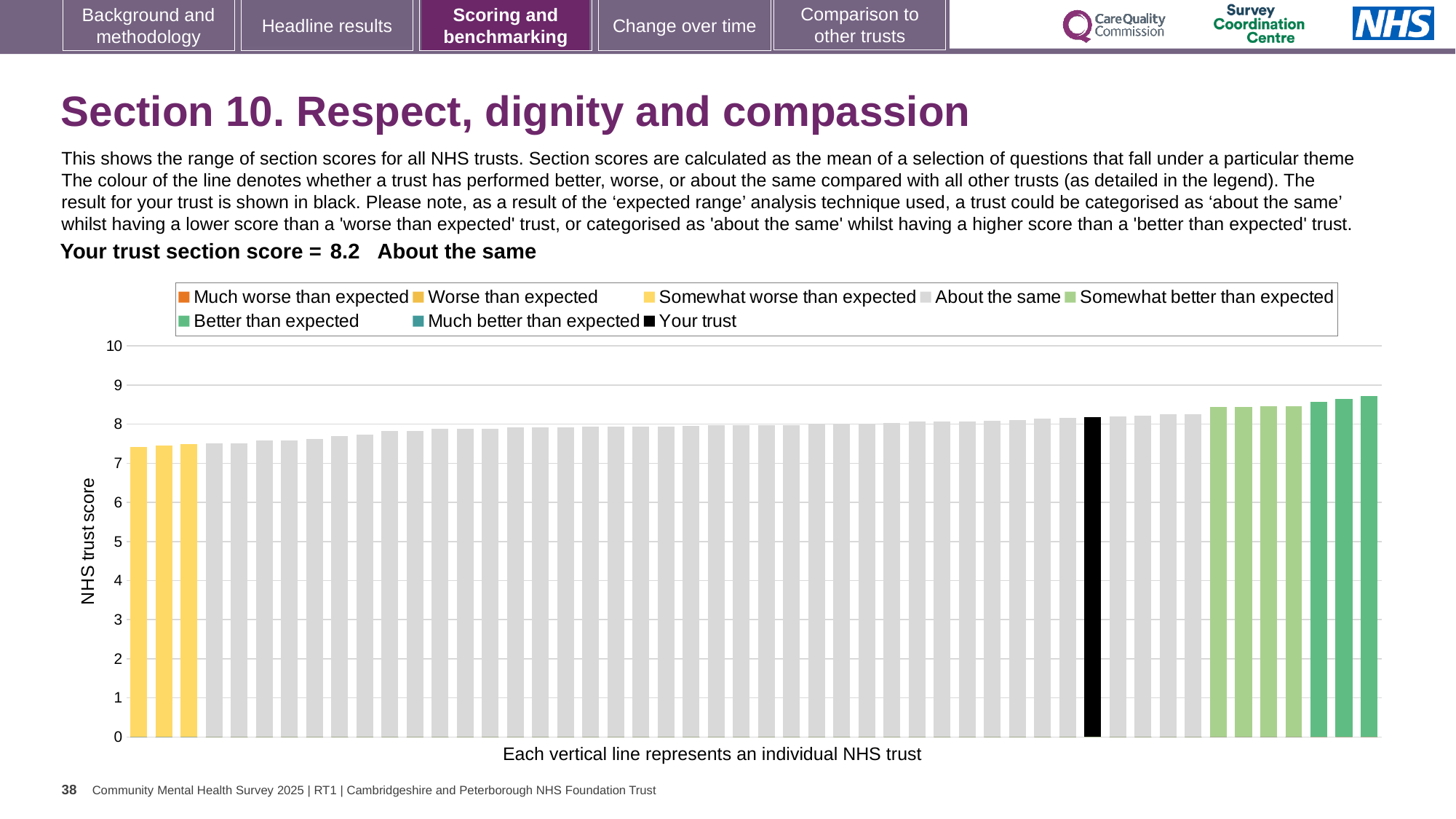
Is the value for your trust (the black bar) greater or less than 8? greater Is the value of the highest bar greater or less than 9? less Which is larger, the value for your trust (black bar) or the value of the leftmost bar? your trust Is the value of the lowest bar greater or less than 8? less What is the section score for your trust? 8.2 What kind of chart is shown on the slide? bar chart What does each vertical line in the chart represent, according to the x-axis label? an individual NHS trust Which category is your trust placed in for this section? About the same How many bars are coloured as 'Somewhat worse than expected'? 3 Do the bar values rise or fall from left to right along the x axis? rise How many entries does the chart legend list? 8 What is the label on the vertical axis? NHS trust score